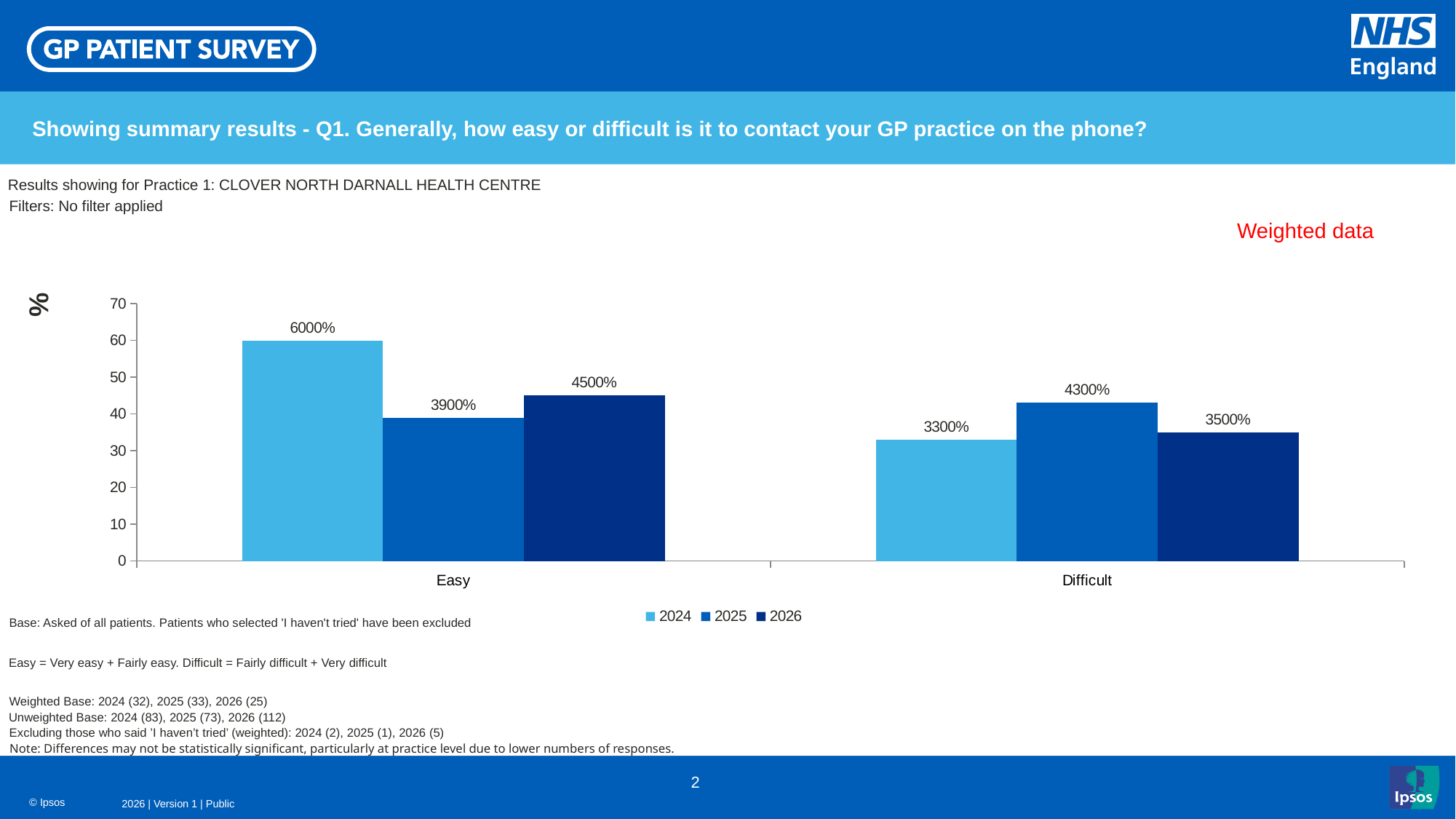
Which is larger: the 2025 value for Easy or the 2025 value for Difficult? Difficult Which year has the lowest value in the Difficult category? 2024 What is the value for 2024 in the Difficult category? 3300% What is the value for 2024 in the Easy category? 6000% How many categories are shown on the x axis? 2 Which year has the highest value in the Easy category? 2024 What is the value for 2025 in the Difficult category? 4300% What is the difference between the 2024 and 2025 values in the Easy category? 2100% What is the value for 2026 in the Easy category? 4500% Which years are listed in the chart legend? 2024, 2025, 2026 How many series does the legend list? 3 What kind of chart is shown on the slide? Bar chart